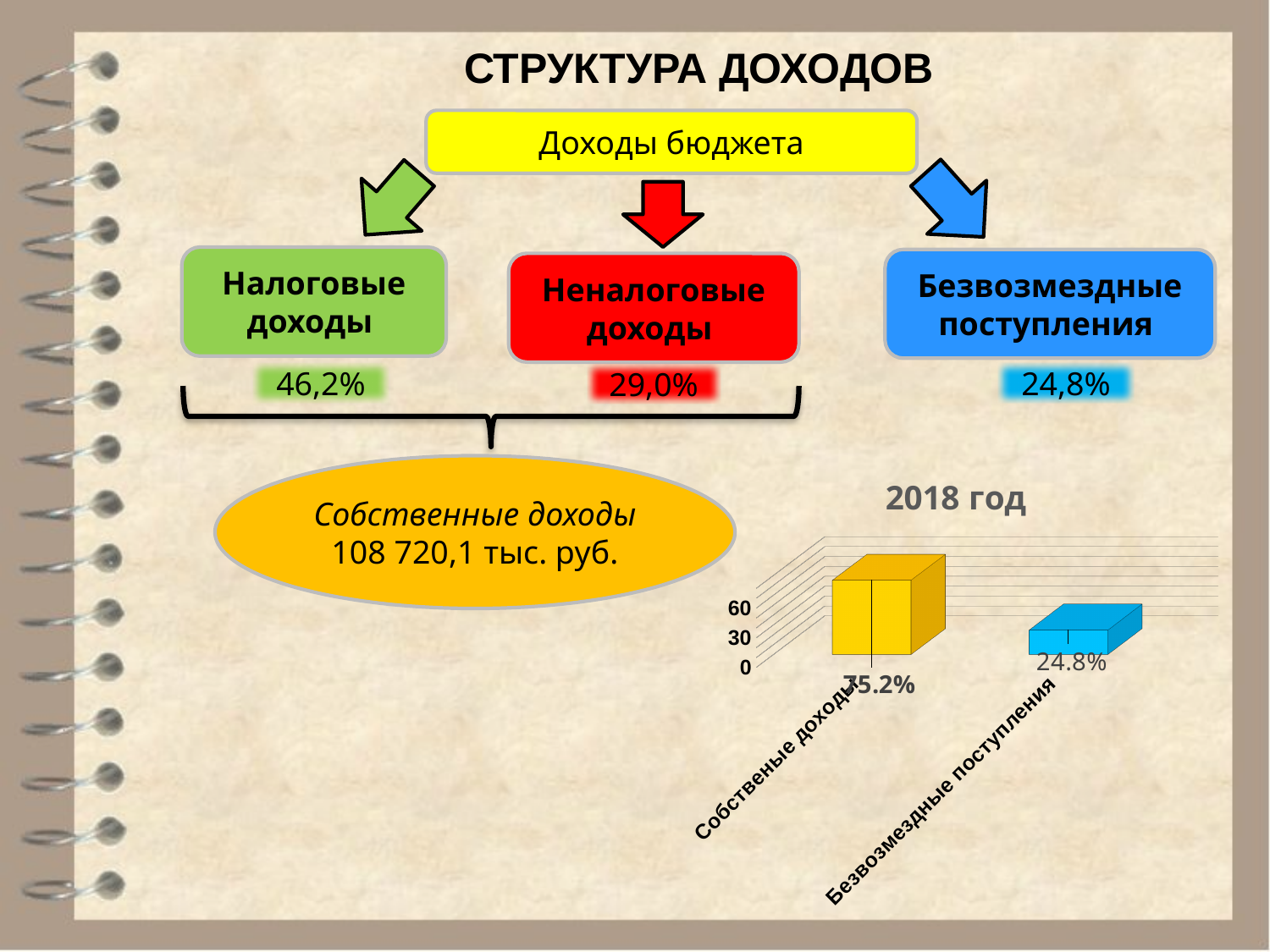
In the "2018 год" chart, is the value for Безвозмездные поступления greater or less than 30? less How many categories are plotted in the "2018 год" chart? 2 In the "2018 год" chart, what is the value for Собственые доходы? 75.2% In the "2018 год" chart, what is the value for Безвозмездные поступления? 24.8% In the "2018 год" chart, is the value for Собственые доходы greater or less than 60? greater Which category has the lowest value in the "2018 год" chart? Безвозмездные поступления Which category has the highest value in the "2018 год" chart? Собственые доходы What is the title of the chart on the slide? 2018 год In the "2018 год" chart, what is the difference between the values for Собственые доходы and Безвозмездные поступления? 50.4% What kind of chart is shown under the title "2018 год"? bar chart What colour is the bar for Безвозмездные поступления in the "2018 год" chart? blue In the "2018 год" chart, which is larger: Собственые доходы or Безвозмездные поступления? Собственые доходы